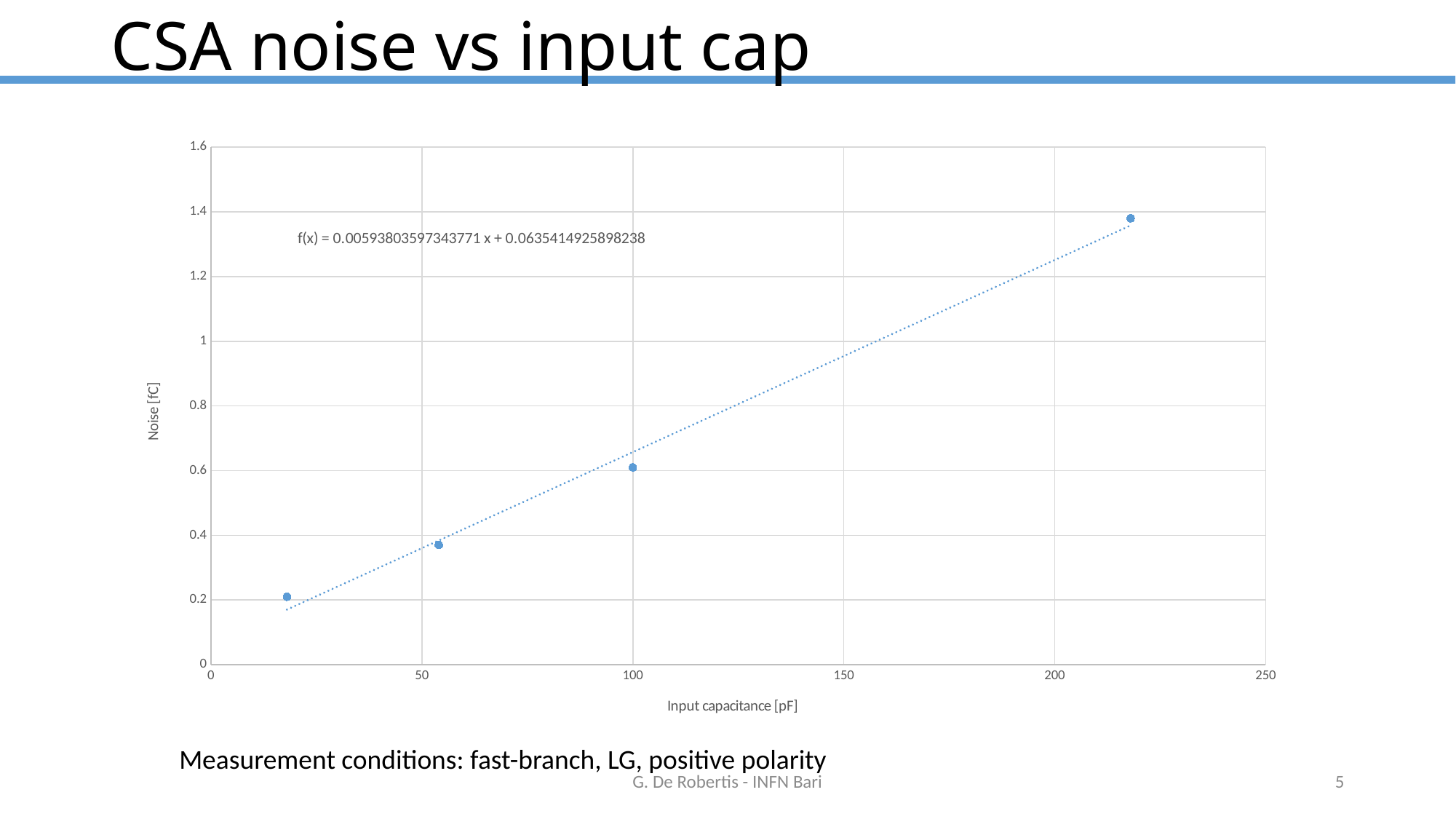
Which has the larger noise value, the point at 100 pF or the point near 50 pF? the point at 100 pF Is the noise value for the leftmost data point greater or less than 0.4? less Is the noise value for the rightmost data point greater or less than 1.2? greater What kind of chart is shown on the slide? scatter chart Which data point has the highest noise: the one at the smallest or the one at the largest input capacitance? the one at the largest input capacitance Is the noise value for the point near 50 pF greater or less than 0.6? less Does the noise rise or fall as input capacitance increases? rises What is the label of the x axis? Input capacitance [pF] How many data points are plotted in the chart? 4 What is the label of the y axis? Noise [fC]